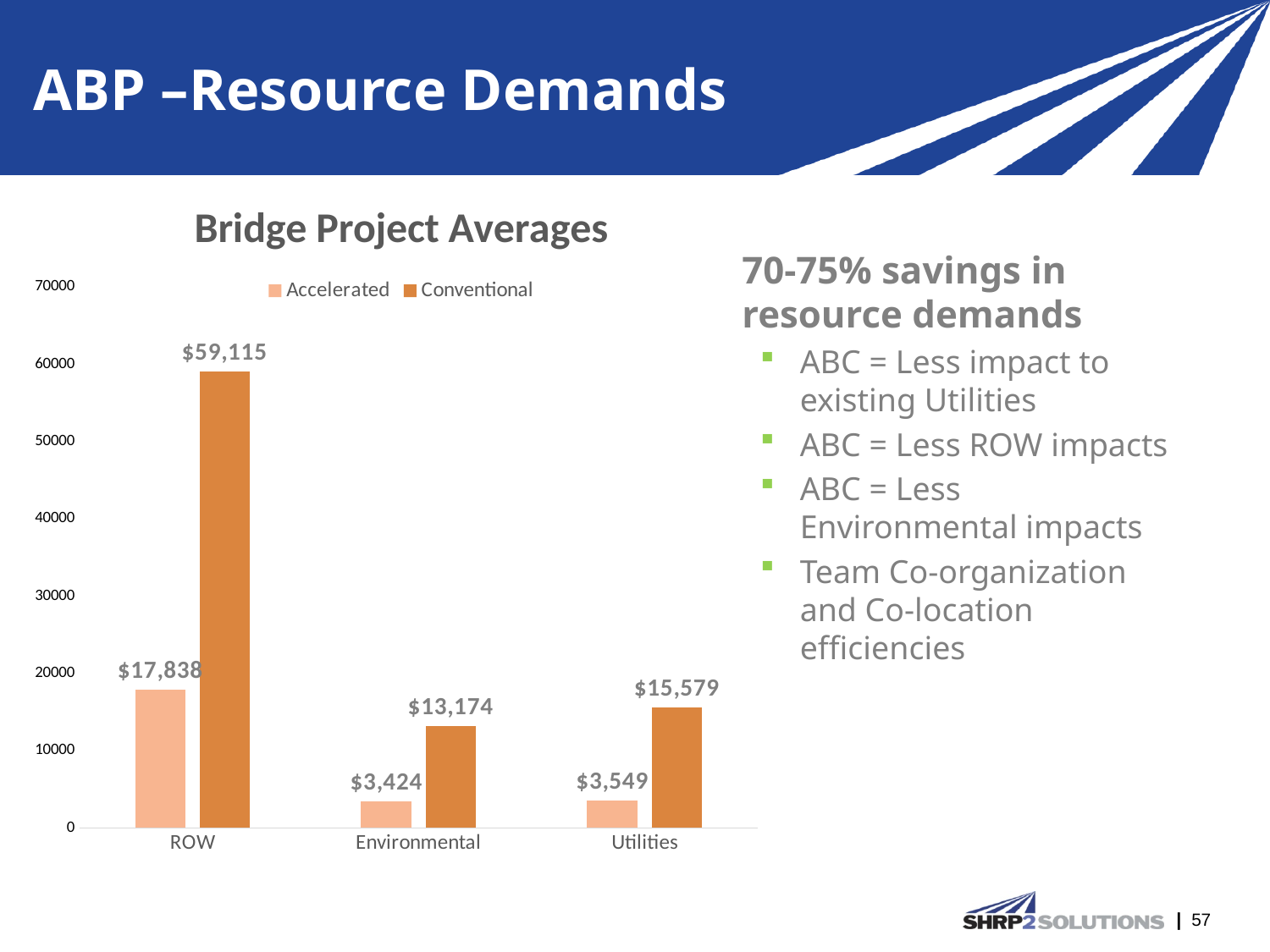
What is the Accelerated value for Environmental in the Bridge Project Averages chart? $3,424 What is the difference between the Conventional and Accelerated values for Utilities in the Bridge Project Averages chart? $12,030 Which category has the lowest Accelerated value in the Bridge Project Averages chart? Environmental What is the Conventional value for ROW in the Bridge Project Averages chart? $59,115 What is the Conventional value for Utilities in the Bridge Project Averages chart? $15,579 How many categories are shown on the x axis of the Bridge Project Averages chart? 3 In the Bridge Project Averages chart, which is larger: the Conventional value for Environmental or the Conventional value for Utilities? Utilities What is the Accelerated value for ROW in the Bridge Project Averages chart? $17,838 What is the difference between the Conventional and Accelerated values for ROW in the Bridge Project Averages chart? $41,277 Which category has the highest Conventional value in the Bridge Project Averages chart? ROW What kind of chart is the Bridge Project Averages chart? Bar chart How many series does the legend of the Bridge Project Averages chart list? 2